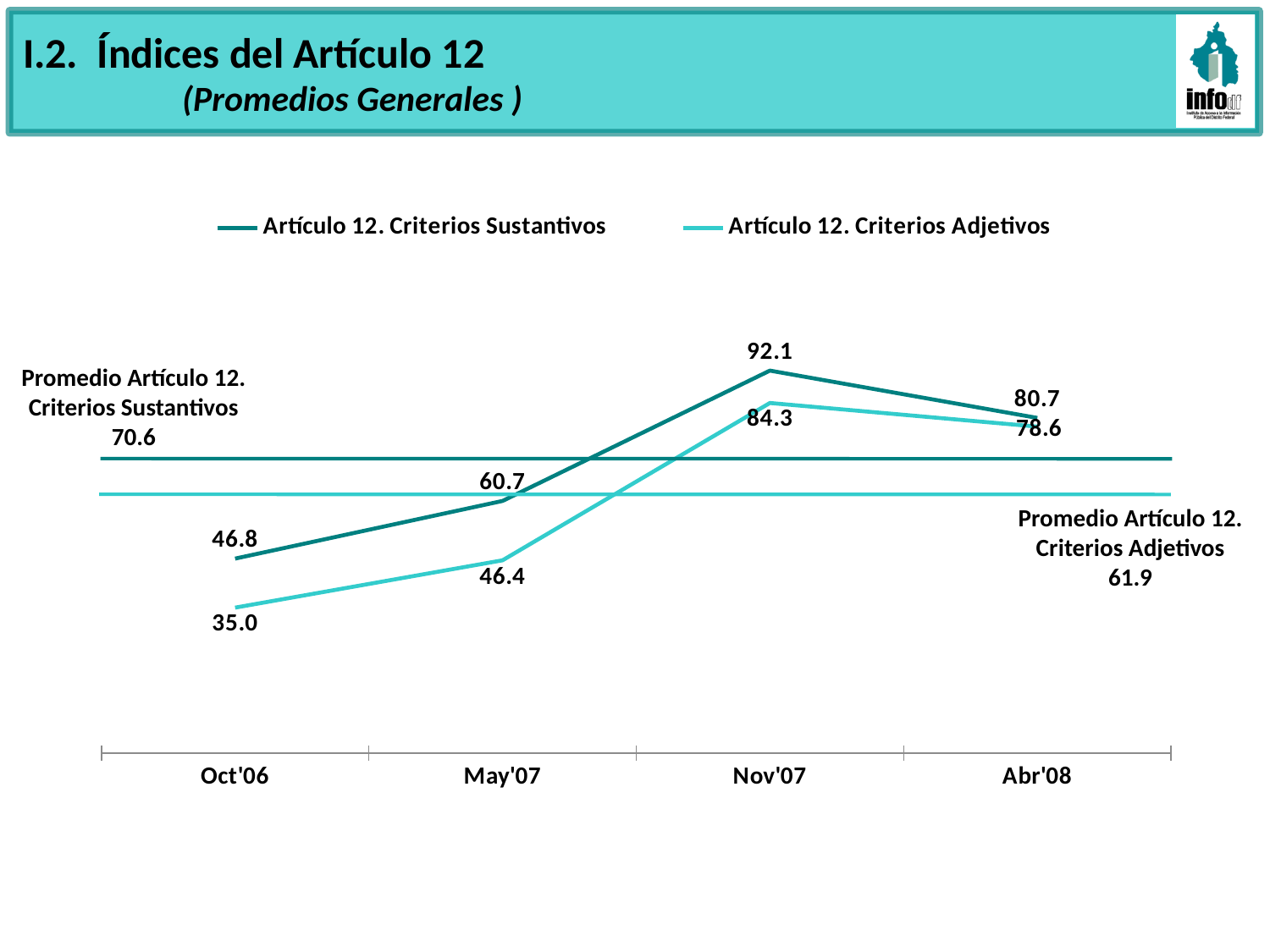
What is the value of Artículo 12. Criterios Adjetivos at Oct'06? 35.0 At which period does Artículo 12. Criterios Adjetivos reach its highest value? Nov'07 What is the value of Artículo 12. Criterios Adjetivos at Abr'08? 78.6 What is the value of Artículo 12. Criterios Sustantivos at May'07? 60.7 Which series has the higher value at Abr'08, Criterios Sustantivos or Criterios Adjetivos? Criterios Sustantivos What is the difference between Artículo 12. Criterios Sustantivos and Artículo 12. Criterios Adjetivos at Oct'06? 11.8 What is the value shown for Promedio Artículo 12. Criterios Adjetivos? 61.9 What is the value of Artículo 12. Criterios Sustantivos at Nov'07? 92.1 How many series does the legend list? 2 What type of chart is shown on the slide? line chart At which period is Artículo 12. Criterios Sustantivos lowest? Oct'06 How many periods are shown on the x axis? 4